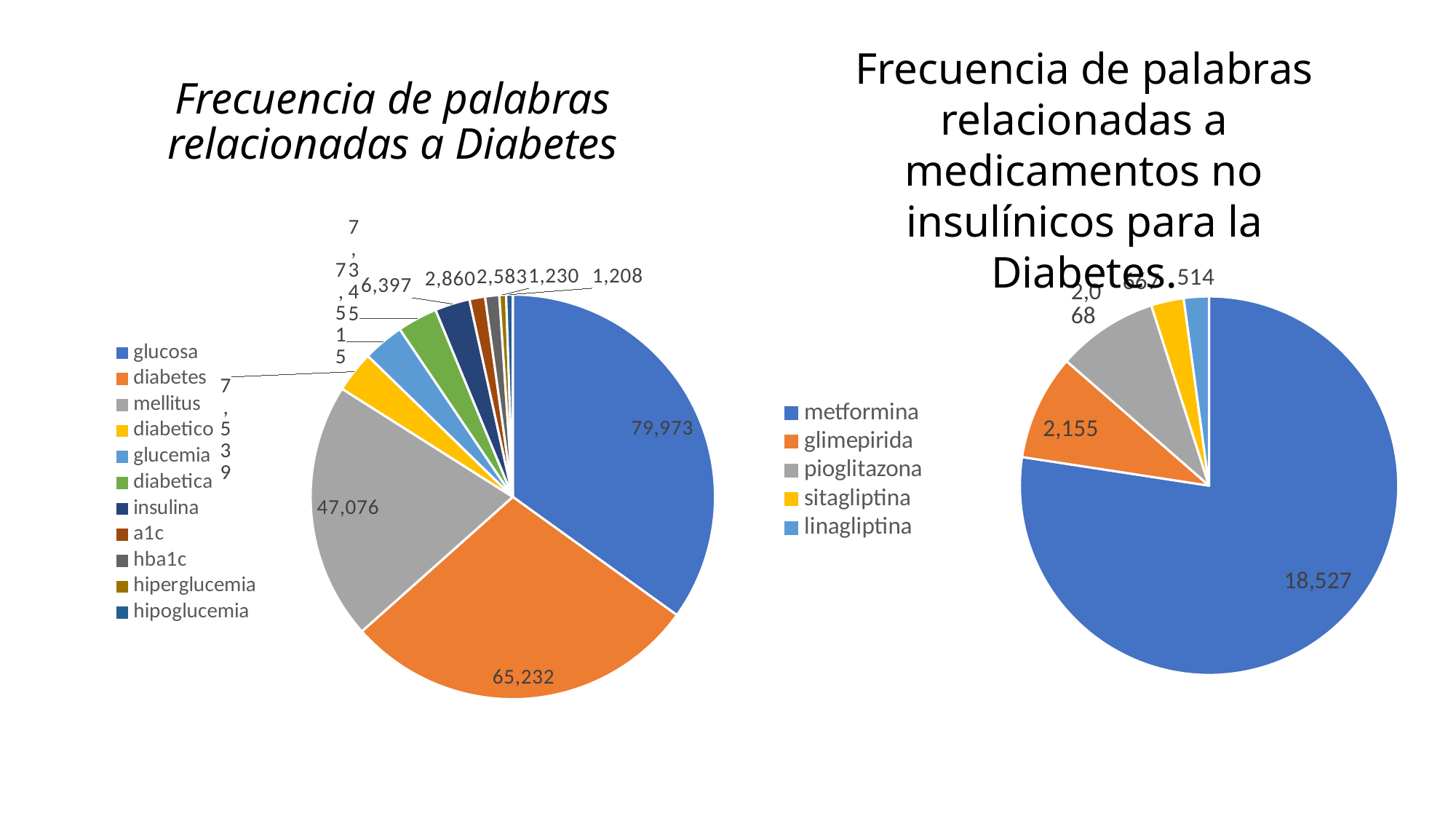
In 'Frecuencia de palabras relacionadas a Diabetes', what is the value for mellitus? 47,076 In 'Frecuencia de palabras relacionadas a Diabetes', what is the value for glucosa? 79,973 In 'Frecuencia de palabras relacionadas a Diabetes', what is the value for diabetes? 65,232 What type of chart is used in 'Frecuencia de palabras relacionadas a Diabetes'? pie chart In 'Frecuencia de palabras relacionadas a medicamentos no insulínicos para la Diabetes', what is the value for glimepirida? 2,155 In 'Frecuencia de palabras relacionadas a medicamentos no insulínicos para la Diabetes', which category has the smallest slice? linagliptina In 'Frecuencia de palabras relacionadas a Diabetes', which category has the largest slice? glucosa In 'Frecuencia de palabras relacionadas a medicamentos no insulínicos para la Diabetes', what is the value for metformina? 18,527 In 'Frecuencia de palabras relacionadas a Diabetes', how many categories does the legend list? 11 In 'Frecuencia de palabras relacionadas a Diabetes', what is the difference between glucosa and diabetes? 14,741 In 'Frecuencia de palabras relacionadas a medicamentos no insulínicos para la Diabetes', how many categories does the legend list? 5 In 'Frecuencia de palabras relacionadas a Diabetes', which is larger, insulina or a1c? insulina